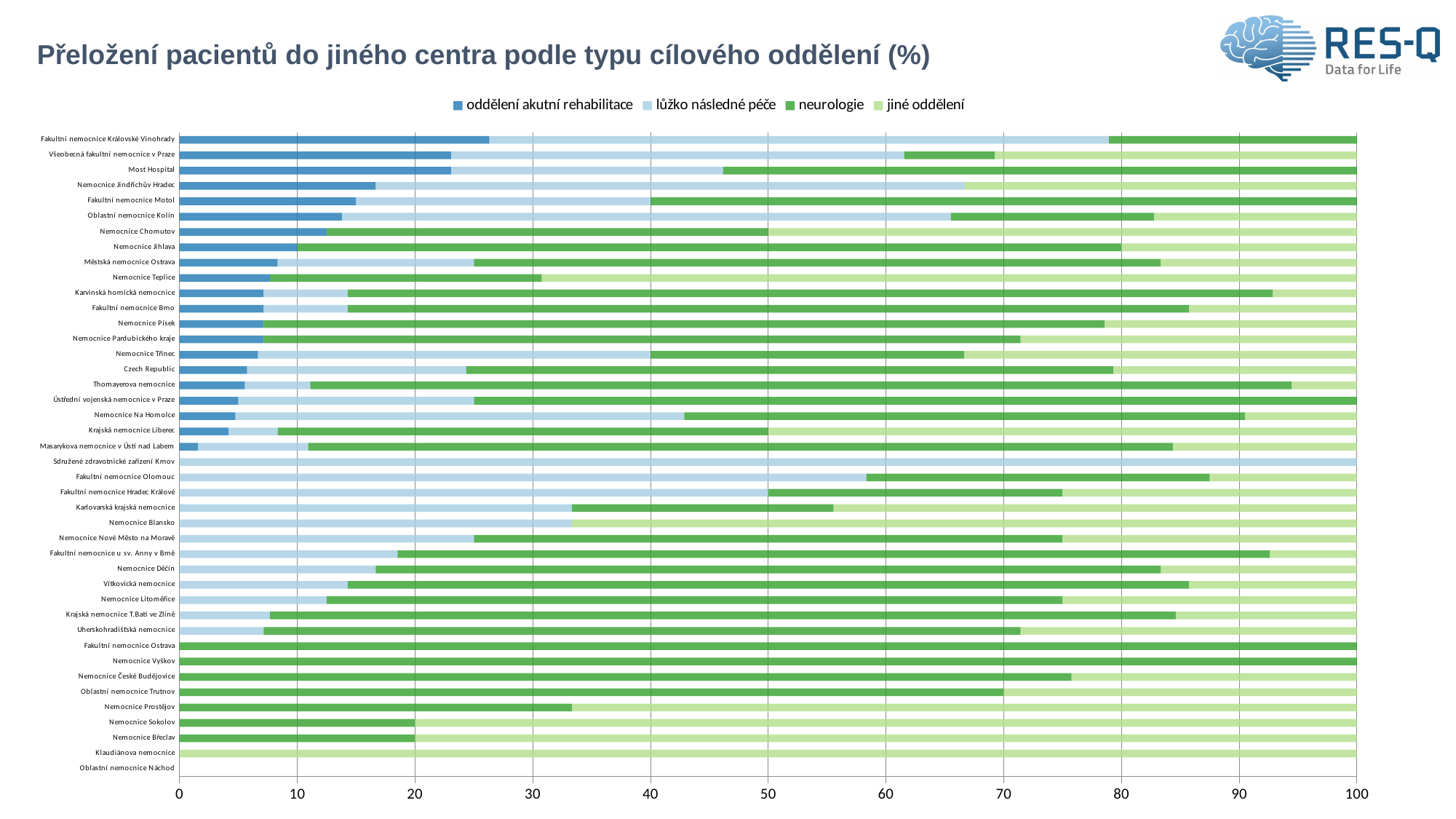
Which hospital has the highest value for 'oddělení akutní rehabilitace'? Fakultní nemocnice Královské Vinohrady What is the value of 'neurologie' for Fakultní nemocnice Ostrava? 100 What is the title of the chart? Přeložení pacientů do jiného centra podle typu cílového oddělení (%) Is the value of 'neurologie' for Nemocnice Prostějov greater or less than 30? greater What kind of chart is shown on the slide? bar chart What is the value of 'lůžko následné péče' for Sdružené zdravotnické zařízení Krnov? 100 Which has a larger value for 'oddělení akutní rehabilitace', Most Hospital or Nemocnice Jihlava? Most Hospital What is the value of 'jiné oddělení' for Klaudiánova nemocnice? 100 How many series does the legend list? 4 Is the value of 'oddělení akutní rehabilitace' for Fakultní nemocnice Královské Vinohrady greater or less than 20? greater Which series is shown in the darkest blue colour in the legend? oddělení akutní rehabilitace How many hospitals (categories) are listed on the vertical axis? 42